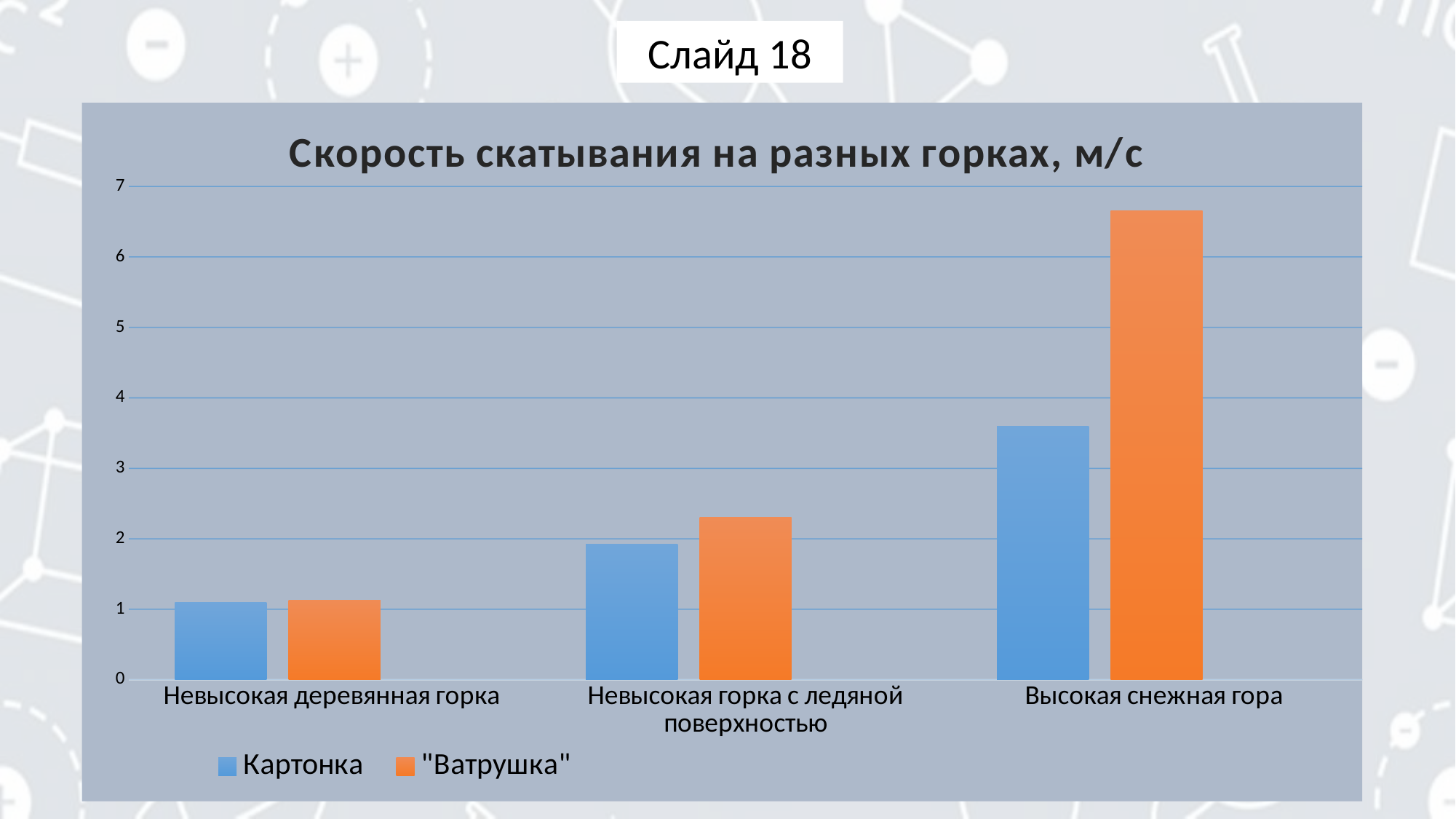
Which category has the highest value for "Ватрушка"? Высокая снежная гора What is the title of the chart? Скорость скатывания на разных горках, м/с Do the values for Картонка rise or fall from left to right along the x axis? rise How many categories are shown on the x axis? 3 How many series does the legend list? 2 Is the value for Картонка on Высокая снежная гора greater or less than 4? less Is the value for "Ватрушка" on Невысокая горка с ледяной поверхностью greater or less than 2? greater Is the value for "Ватрушка" on Высокая снежная гора greater or less than 6? greater What kind of chart is shown on the slide? bar chart For Высокая снежная гора, which series has the larger value, Картонка or "Ватрушка"? "Ватрушка" Which category has the lowest value for Картонка? Невысокая деревянная горка